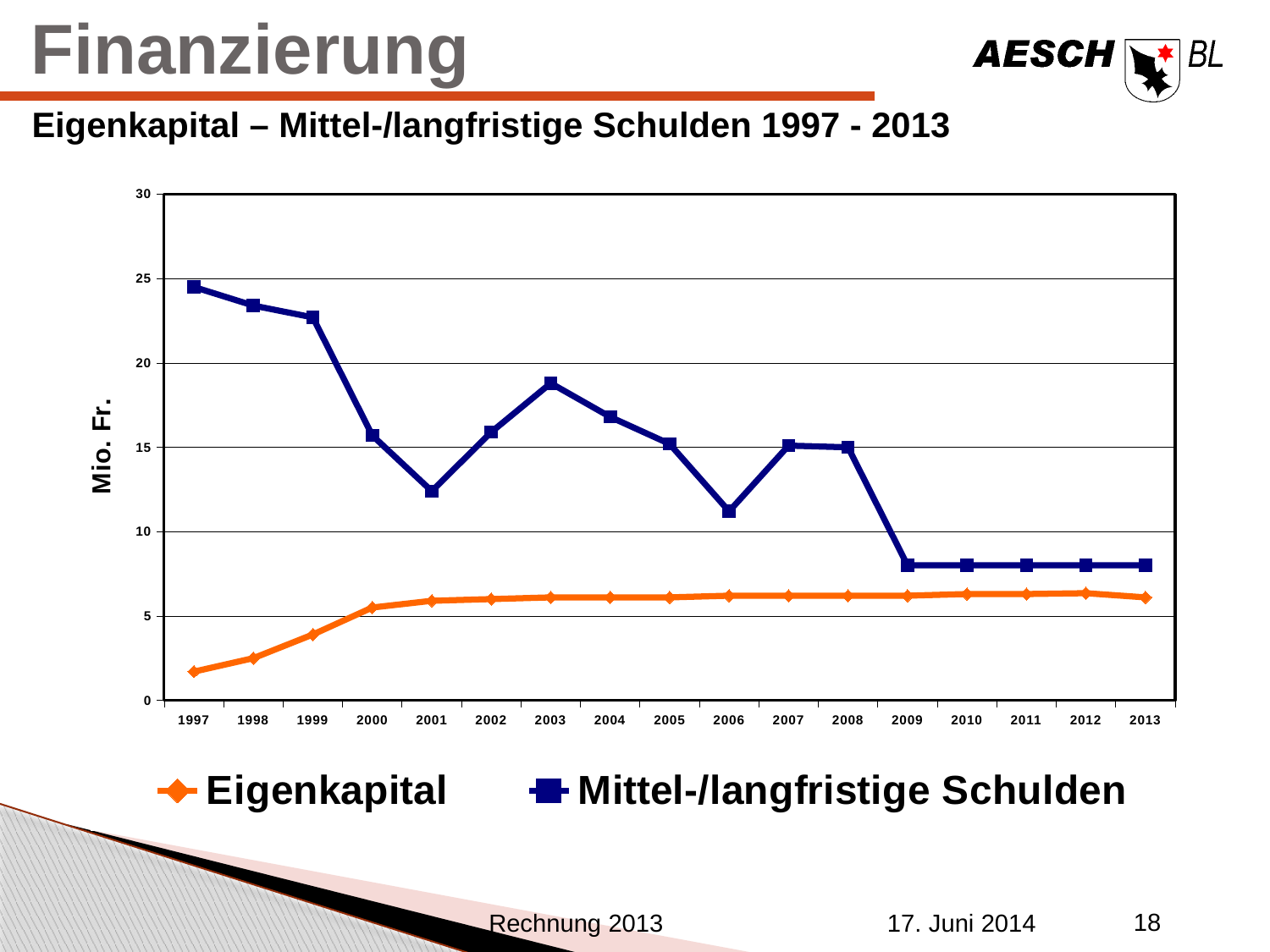
In which year is the value for Mittel-/langfristige Schulden highest? 1997 Is the value for Eigenkapital in 1997 greater or less than 5? less What is the label of the y axis? Mio. Fr. Is the value for Mittel-/langfristige Schulden in 1997 greater or less than 20? greater Is the value for Eigenkapital in 2013 greater or less than 5? greater How many years are plotted along the x axis? 17 What kind of chart is shown on the slide? line chart Which series has the larger value in 2003, Eigenkapital or Mittel-/langfristige Schulden? Mittel-/langfristige Schulden In which year is the value for Eigenkapital lowest? 1997 Does the value for Eigenkapital rise or fall from 1997 to 2000? rise How many series does the legend list? 2